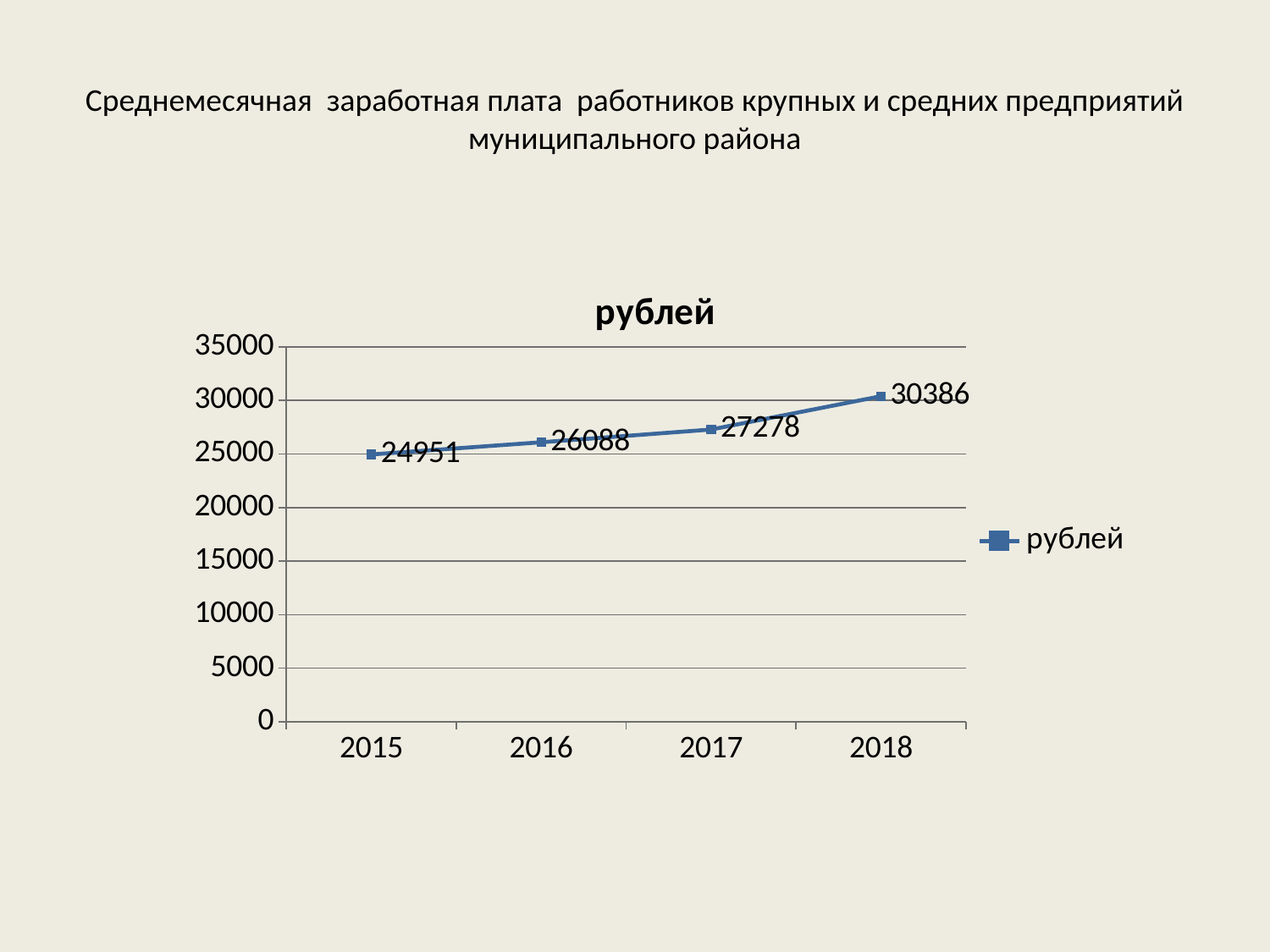
What is the value for 2017? 27278 Which year has the highest value? 2018 Which year has the lowest value? 2015 How many years are plotted on the x axis? 4 What is the difference between the values for 2016 and 2015? 1137 What is the difference between the values for 2018 and 2017? 3108 Do the values rise or fall from 2015 to 2018? rise Which is larger, the value for 2017 or the value for 2016? 2017 What is the value for 2015? 24951 What is the value for 2018? 30386 What kind of chart is shown? line chart What is the value for 2016? 26088